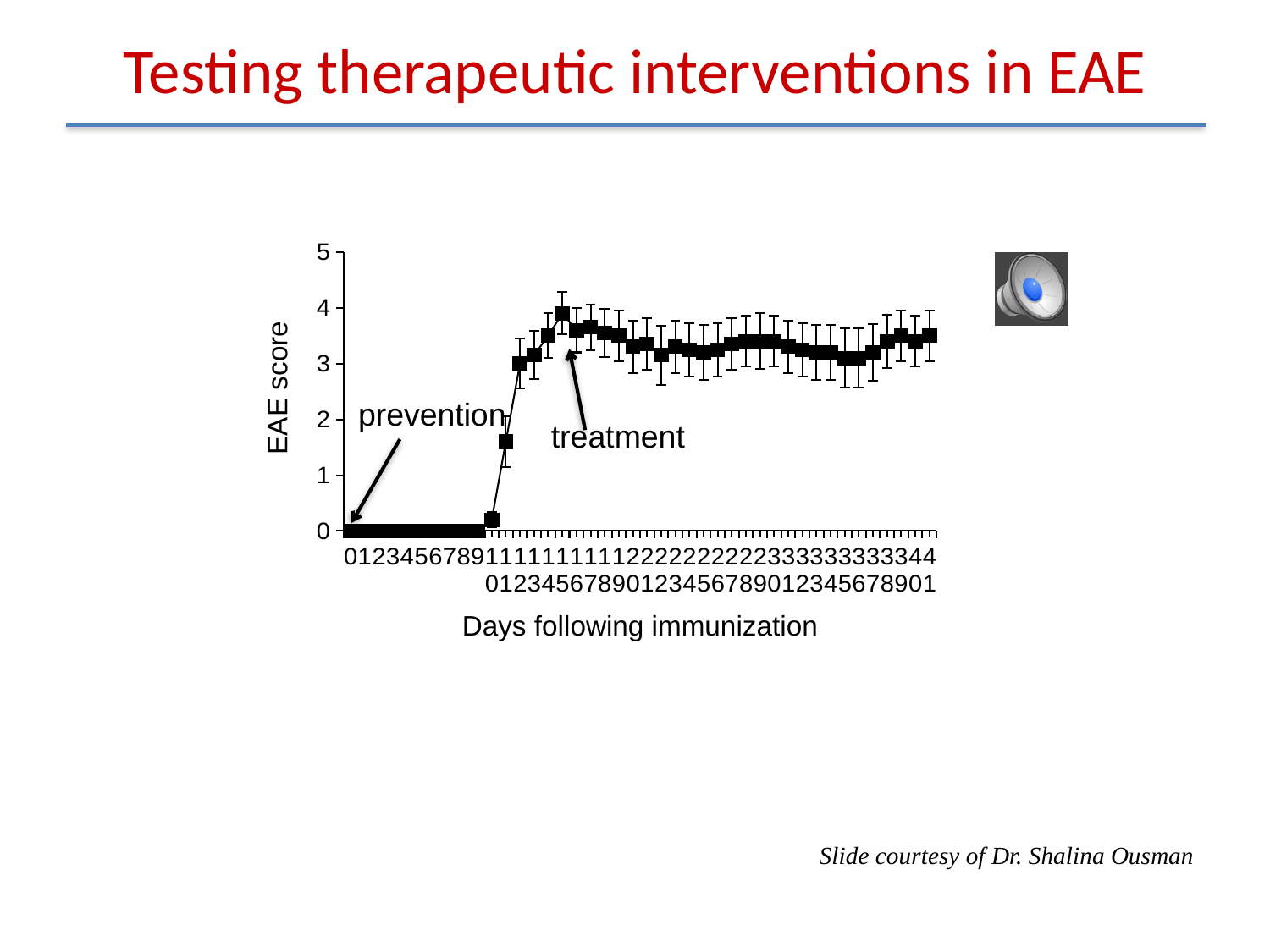
What is the EAE score on day 0 following immunization? 0 Is the EAE score on day 10 greater or less than 1? less What is the label of the y axis? EAE score Is the EAE score on day 15 greater or less than 3? greater What kind of chart is shown on the slide? line chart Is the EAE score on day 20 greater or less than 3? greater Does the EAE score rise or fall between day 9 and day 15? rise On which day following immunization is the EAE score highest? 15 What is the label of the x axis? Days following immunization Is the EAE score on day 15 larger or smaller than on day 11? larger What is the EAE score on day 5 following immunization? 0